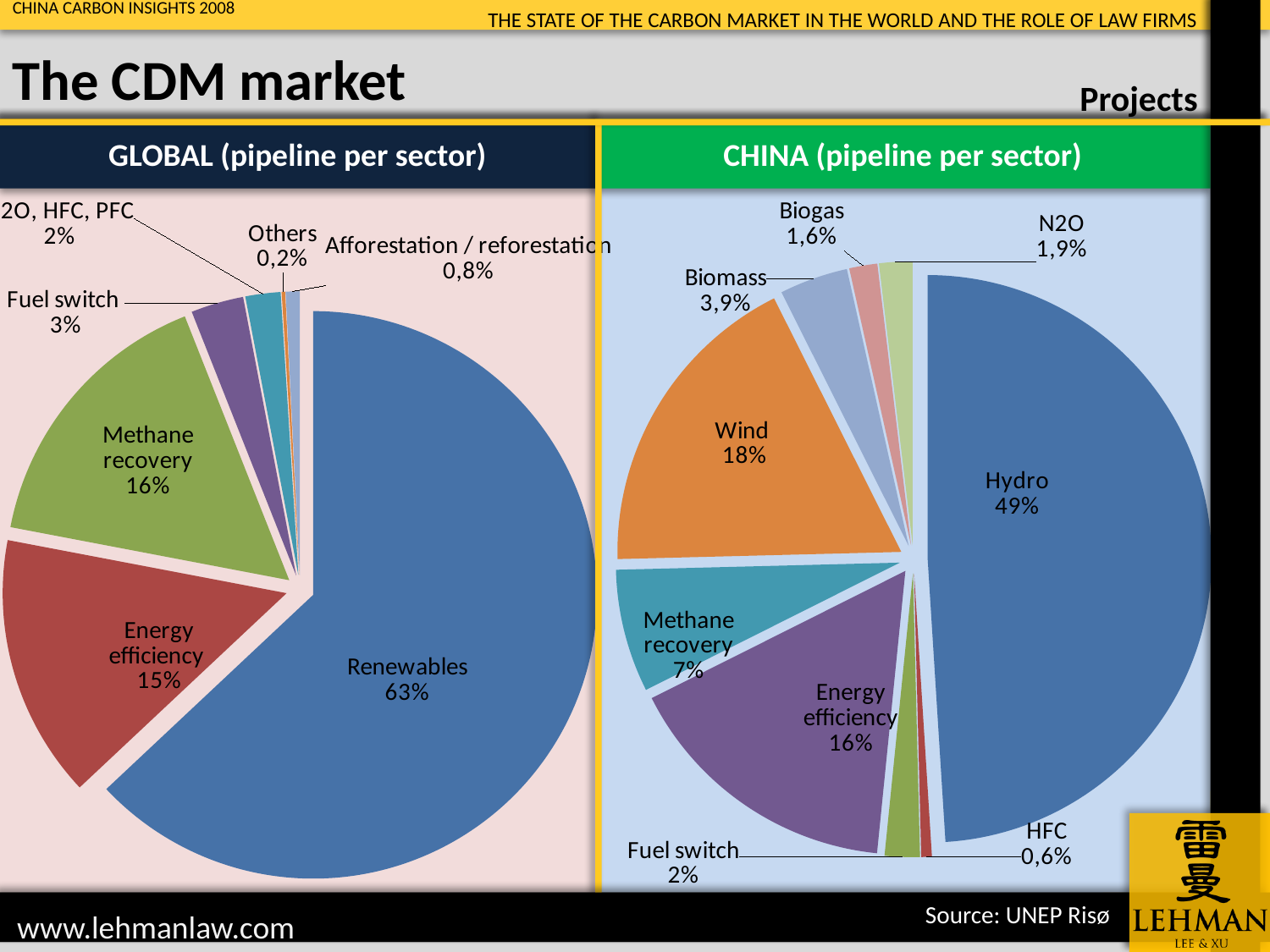
In the GLOBAL (pipeline per sector) chart, what share does Renewables have? 63% In the CHINA (pipeline per sector) chart, what share does Hydro have? 49% In the GLOBAL (pipeline per sector) chart, what share does Methane recovery have? 16% In the GLOBAL (pipeline per sector) chart, what is the difference between the Renewables share and the Energy efficiency share? 48% In the CHINA (pipeline per sector) chart, what share does Biomass have? 3,9% In the CHINA (pipeline per sector) chart, what is the difference between the Wind share and the Methane recovery share? 11% In the GLOBAL (pipeline per sector) chart, which sector has the smallest share? Others In the CHINA (pipeline per sector) chart, which is larger, Wind or Energy efficiency? Wind How many sectors are shown in the CHINA (pipeline per sector) chart? 9 What type of chart is the GLOBAL (pipeline per sector) chart? Pie chart In the GLOBAL (pipeline per sector) chart, which sector has the largest share? Renewables In the CHINA (pipeline per sector) chart, which sector has the smallest share? HFC